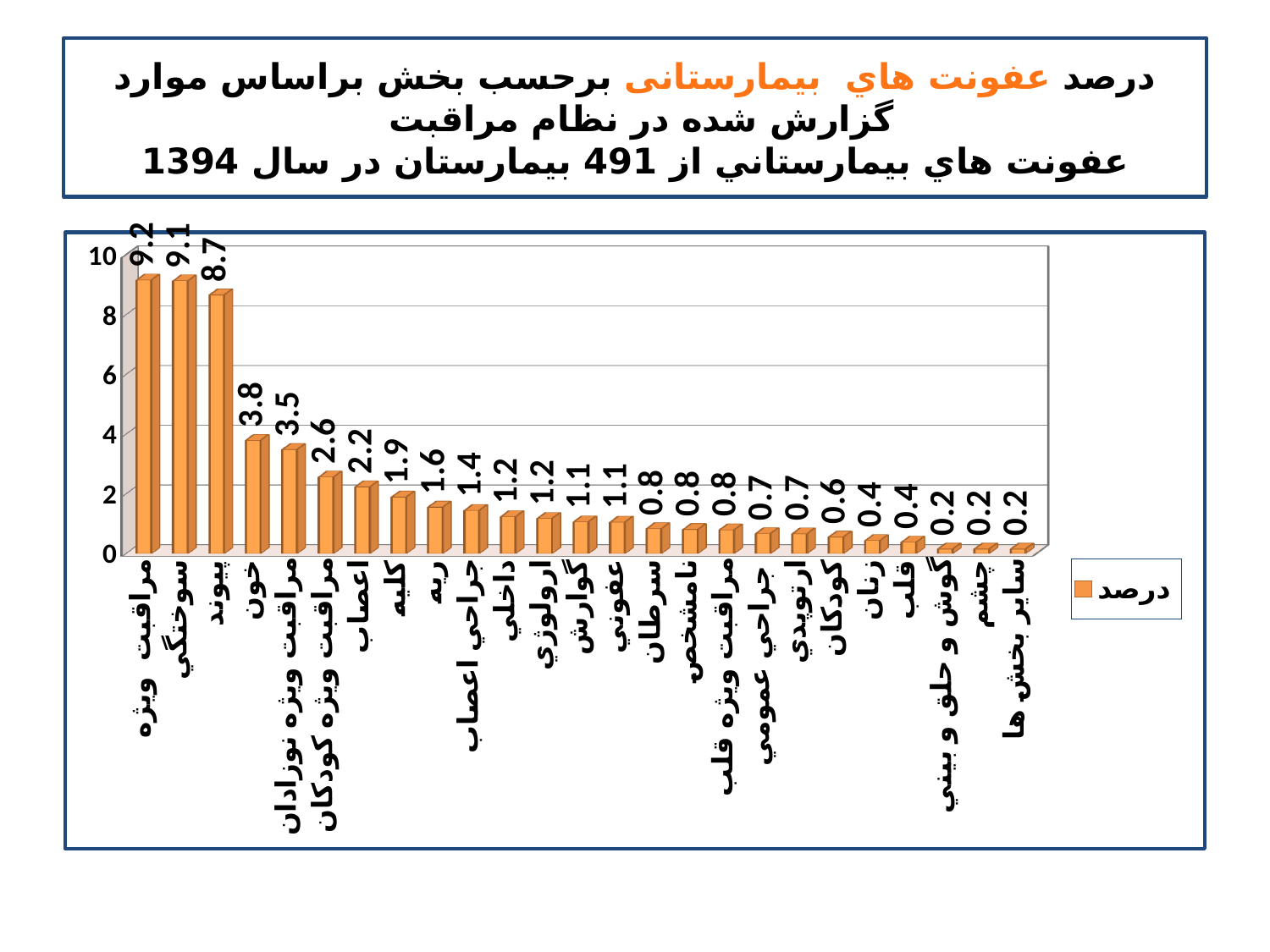
What is the legend entry for the series? درصد What is the value for کودکان? 0.6 How many series does the legend list? 1 What is the value for خون? 3.8 Which category has the highest value? مراقبت ویژه What is the value for پیوند? 8.7 What type of chart is shown on the slide? bar chart What is the value for مراقبت ویژه? 9.2 What is the difference between the values for مراقبت ویژه and پیوند? 0.5 How many categories are shown on the x axis? 25 Which is larger, the value for مراقبت ویژه نوزادان or the value for مراقبت ویژه کودکان? مراقبت ویژه نوزادان What is the value for کلیه? 1.9